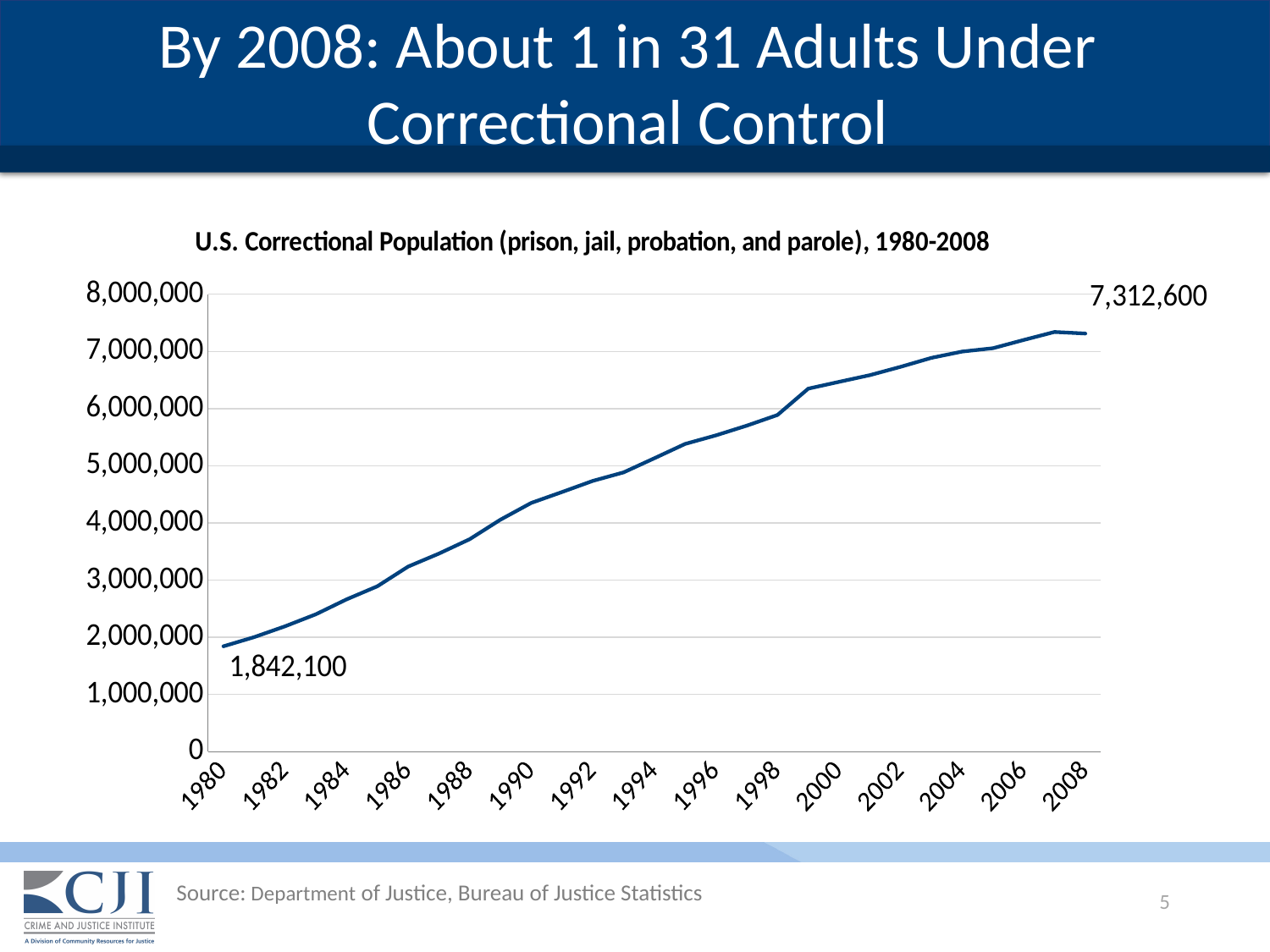
Which is larger, the value for 1980 or the value for 2008? 2008 How many year labels are shown on the x axis? 15 What is the difference between the 2008 value and the 1980 value? 5,470,500 Is the value for 2000 greater or less than 6,000,000? greater What kind of chart is shown on the slide? line chart Which year has the lowest correctional population on the chart? 1980 What is the value for 2008 on the chart? 7,312,600 Does the correctional population rise or fall from 1980 to 2008? rise What is the value for 1980 on the chart? 1,842,100 Is the value for 1984 greater or less than 3,000,000? less Is the value for 1990 greater or less than 4,000,000? greater